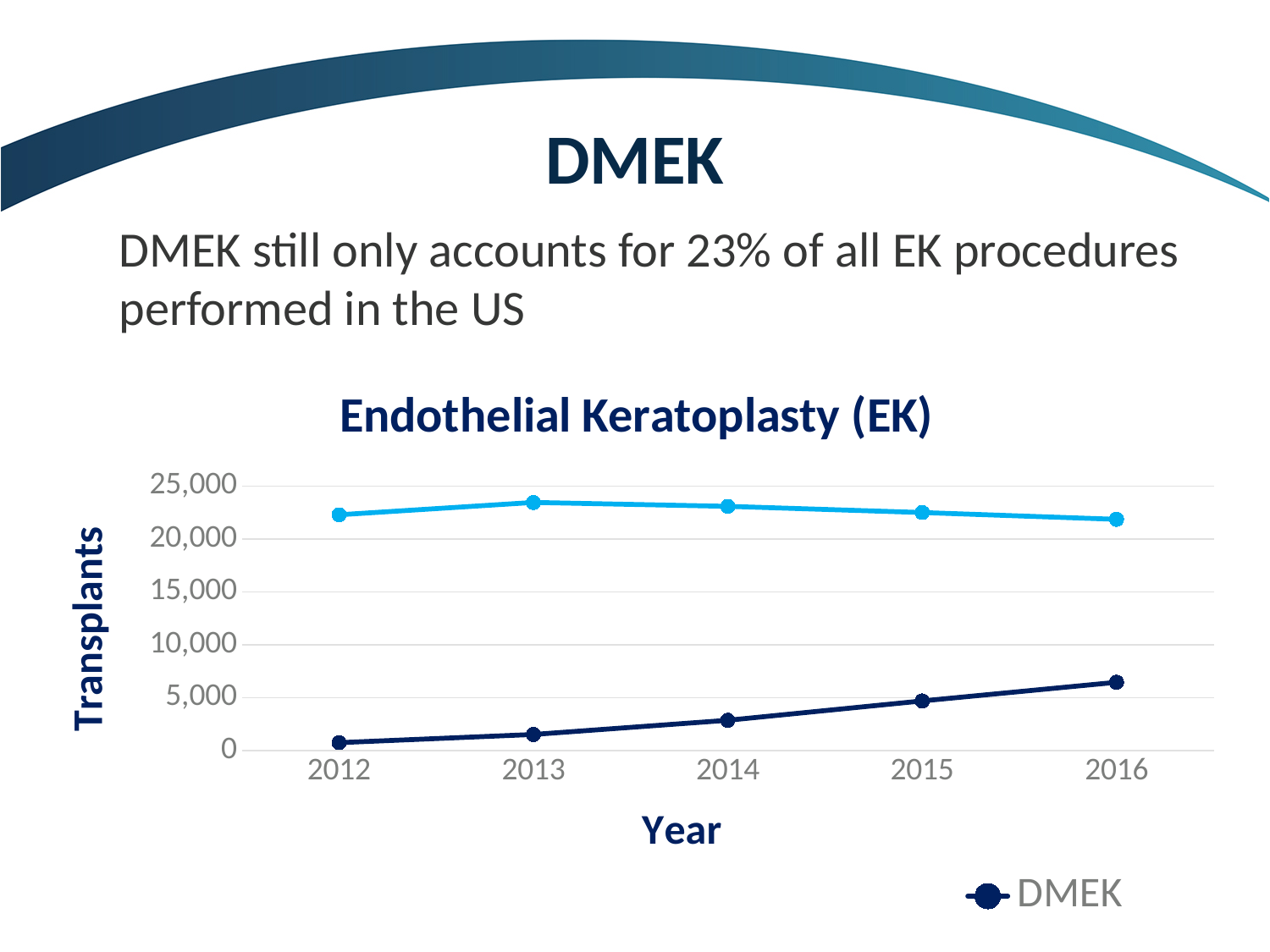
In which year is the DMEK value highest? 2016 Is the DMEK value for 2013 greater or less than 5,000? less How many series does the chart's legend list? 1 Is the DMEK value for 2014 greater or less than 5,000? less Do the DMEK values rise or fall from 2012 to 2016? rise What is the title of the chart? Endothelial Keratoplasty (EK) In which year is the DMEK value lowest? 2012 What kind of chart is shown on the slide? line chart Which is larger, the DMEK value for 2015 or for 2013? 2015 Which series is named in the chart's legend? DMEK How many years are plotted along the x axis of the chart? 5 Is the DMEK value for 2016 greater or less than 5,000? greater